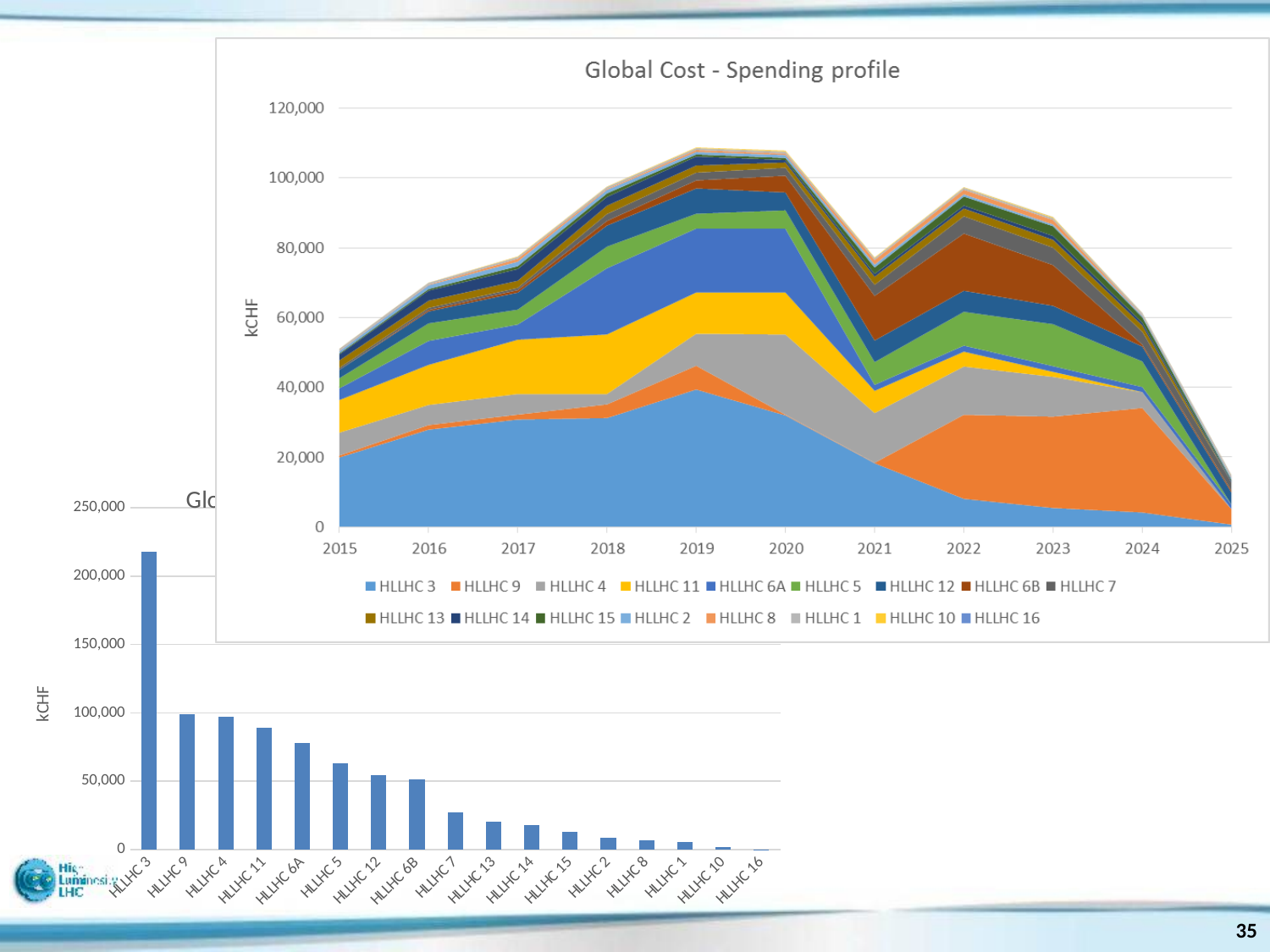
In the bottom-left bar chart, how many bars are there? 17 In the bottom-left bar chart, which category has the highest value? HLLHC 3 In the 'Global Cost - Spending profile' chart, which year has the highest total spending? 2019 In the 'Global Cost - Spending profile' chart, does the total spending rise or fall from 2015 to 2019? rise In the 'Global Cost - Spending profile' chart, how many series does the legend list? 17 In the bottom-left bar chart, is the value for HLLHC 3 greater or less than 200,000? greater What kind of chart is the chart in the bottom-left of the slide? bar chart What kind of chart is the 'Global Cost - Spending profile' chart? stacked area chart In the 'Global Cost - Spending profile' chart, which is larger, the total spending in 2019 or in 2022? 2019 In the 'Global Cost - Spending profile' chart, how many years are shown on the x axis? 11 In the 'Global Cost - Spending profile' chart, is the total spending in 2019 greater or less than 100,000? greater In the 'Global Cost - Spending profile' chart, which year has the lowest total spending? 2025